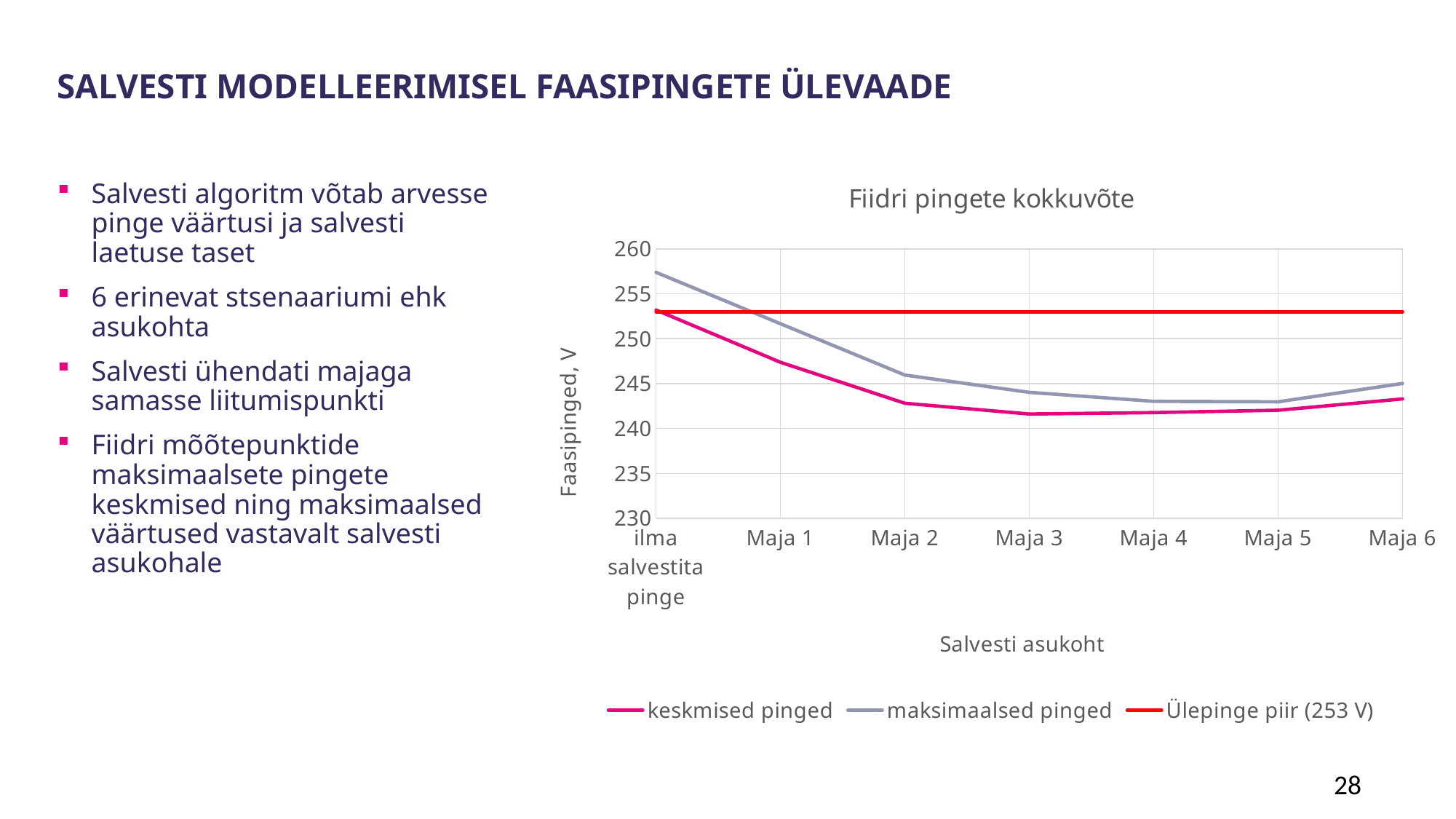
What value does the legend give for the Ülepinge piir series? 253 V How many categories are shown on the x axis of the chart? 7 What is the title of the chart? Fiidri pingete kokkuvõte Is the value of keskmised pinged at Maja 1 greater or less than 250? less Does the keskmised pinged series rise or fall from ilma salvestita pinge to Maja 3? fall Is the value of maksimaalsed pinged at ilma salvestita pinge greater or less than 255? greater How many series does the chart legend list? 3 What kind of chart is shown on the slide? line chart At Maja 1, which series has the larger value: keskmised pinged or maksimaalsed pinged? maksimaalsed pinged Is the value of keskmised pinged at Maja 3 greater or less than 245? less At which category is the keskmised pinged series highest? ilma salvestita pinge At which category is the maksimaalsed pinged series highest? ilma salvestita pinge